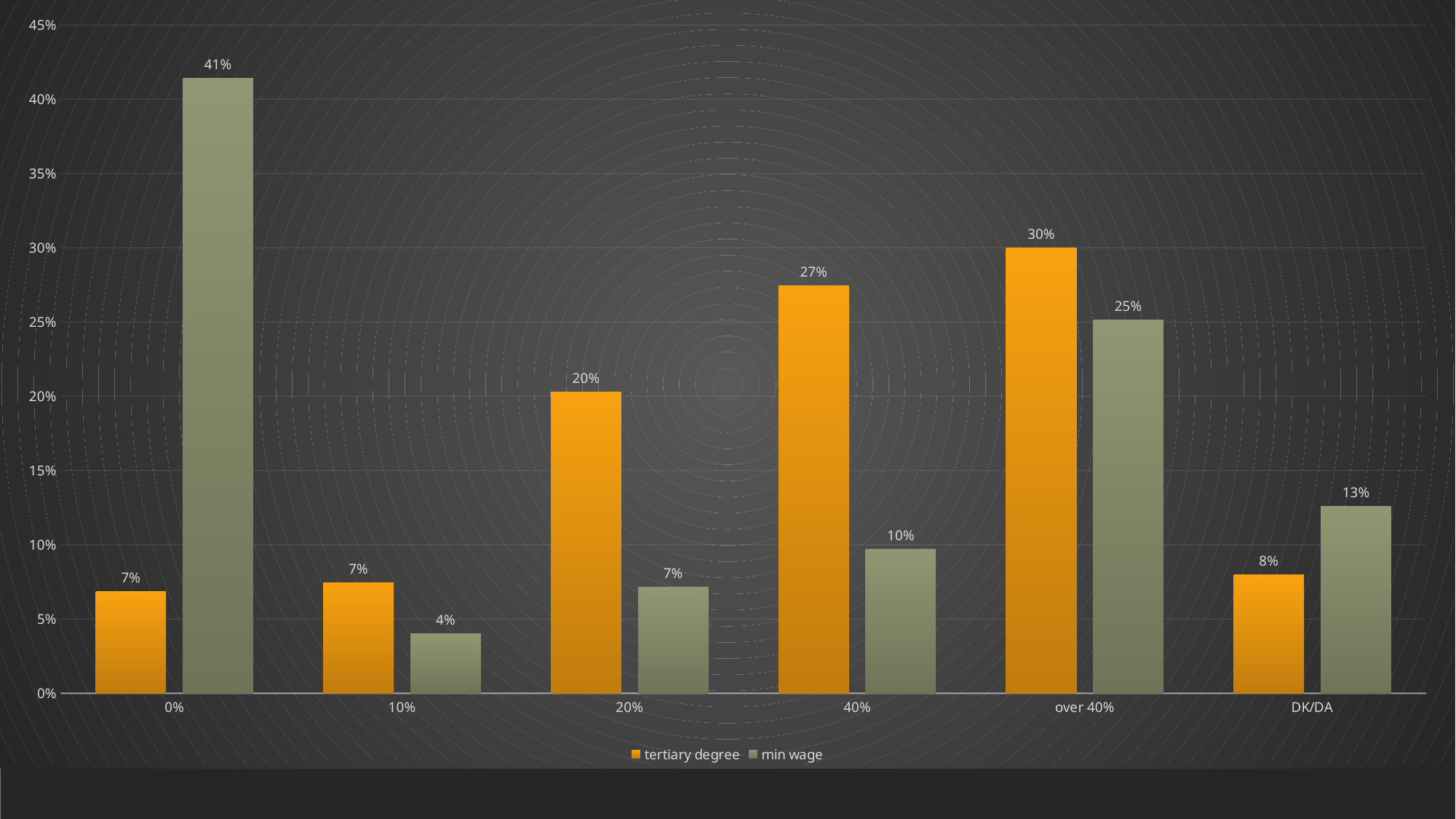
What is the value for tertiary degree in the 0% category? 7% How many categories are shown on the x axis? 6 Which category has the lowest value for the min wage series? 10% How many series does the legend list? 2 What is the difference between the min wage and tertiary degree values in the 0% category? 34% Which category has the highest value for the tertiary degree series? over 40% In the 40% category, which series has the larger value, tertiary degree or min wage? tertiary degree Is the value for min wage in the over 40% category greater or less than 20%? greater What kind of chart is shown on the slide? bar chart What is the value for min wage in the DK/DA category? 13% What is the value for min wage in the 0% category? 41% What is the value for tertiary degree in the over 40% category? 30%